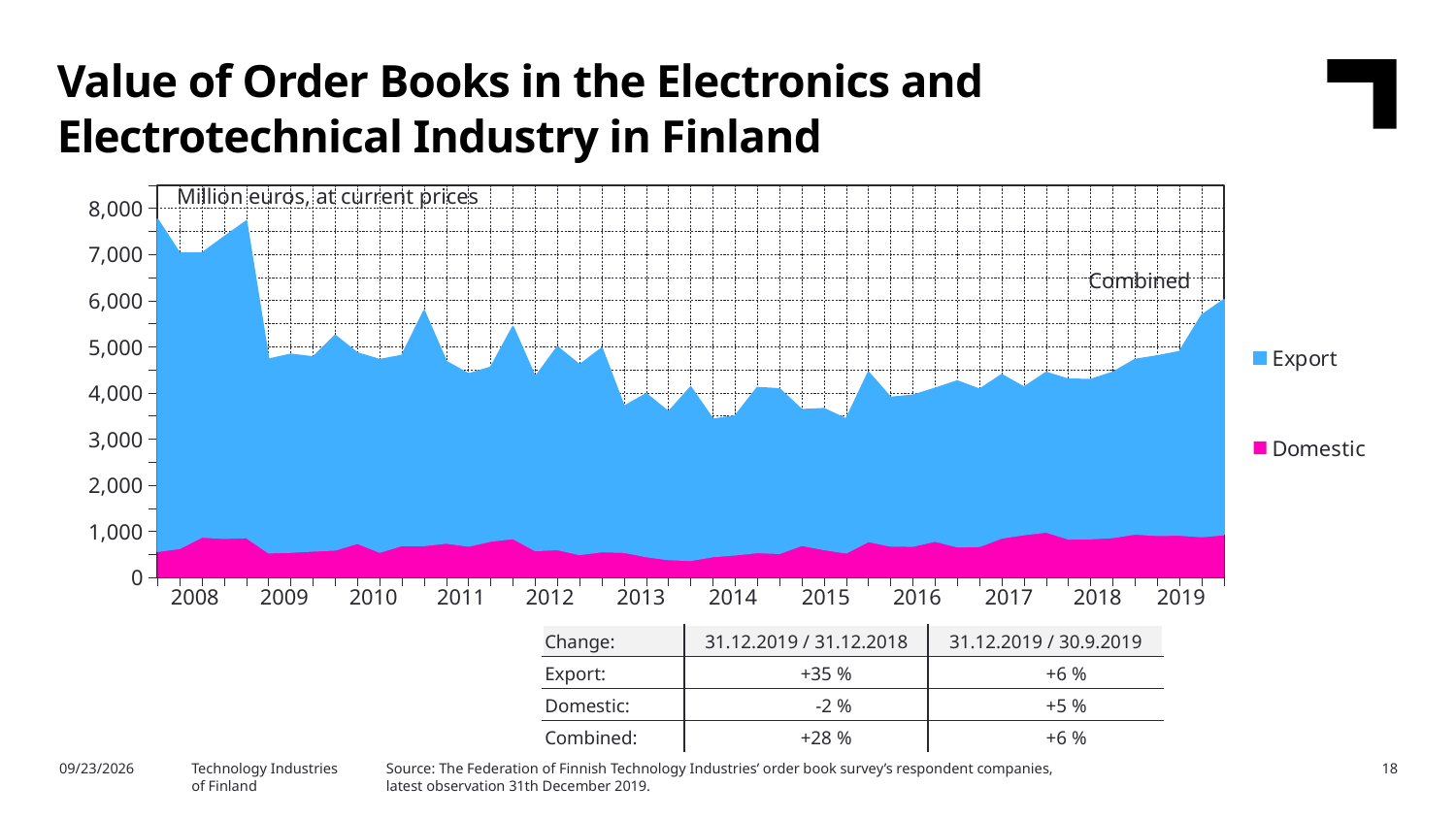
Does the combined value of order books rise or fall from 2016 to the end of 2019? Rise Which is larger, the combined value of order books in 2008 or in 2019? 2008 Which two series are listed in the chart legend? Export and Domestic Is the Domestic value during 2014 greater or less than 1,000? less How many years are labelled on the x axis of the chart? 12 Is the combined value of order books at the start of 2008 greater or less than 7,000? greater Is the combined value of order books during 2014 greater or less than 5,000? less What kind of chart is shown on the slide? Stacked area chart In which year does the combined value of order books reach its highest level? 2008 How many series does the chart legend list? 2 Does the combined value of order books rise or fall from 2008 to 2014? Fall What unit is the chart's vertical axis measured in, according to the label inside the plot area? Million euros, at current prices